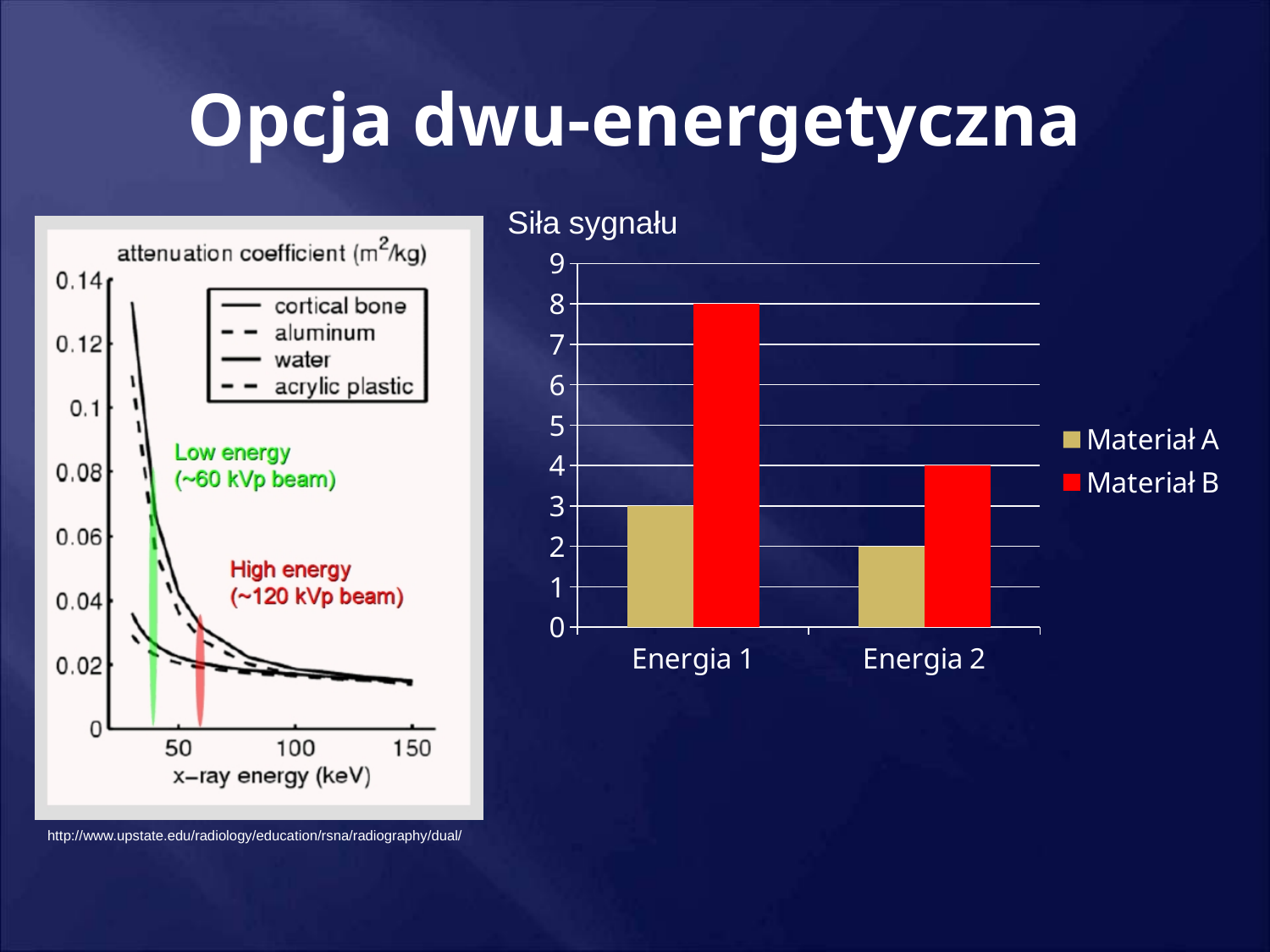
In the attenuation coefficient chart on the left, do the curves rise or fall as x-ray energy increases? fall In the 'Siła sygnału' chart, what is the value for Materiał B at Energia 1? 8 What kind of chart is the 'Siła sygnału' chart on the right? bar chart In the 'Siła sygnału' chart, which is larger at Energia 2: Materiał A or Materiał B? Materiał B How many series does the legend of the attenuation coefficient chart on the left list? 4 In the 'Siła sygnału' chart, what is the value for Materiał B at Energia 2? 4 In the 'Siła sygnału' chart, what is the value for Materiał A at Energia 1? 3 In the 'Siła sygnału' chart, what is the difference between Materiał B and Materiał A at Energia 1? 5 How many series does the legend of the 'Siła sygnału' chart list? 2 In the 'Siła sygnału' chart, which bar is the highest? Materiał B at Energia 1 In the 'Siła sygnału' chart, what is the value for Materiał A at Energia 2? 2 How many categories are shown on the x axis of the 'Siła sygnału' chart? 2